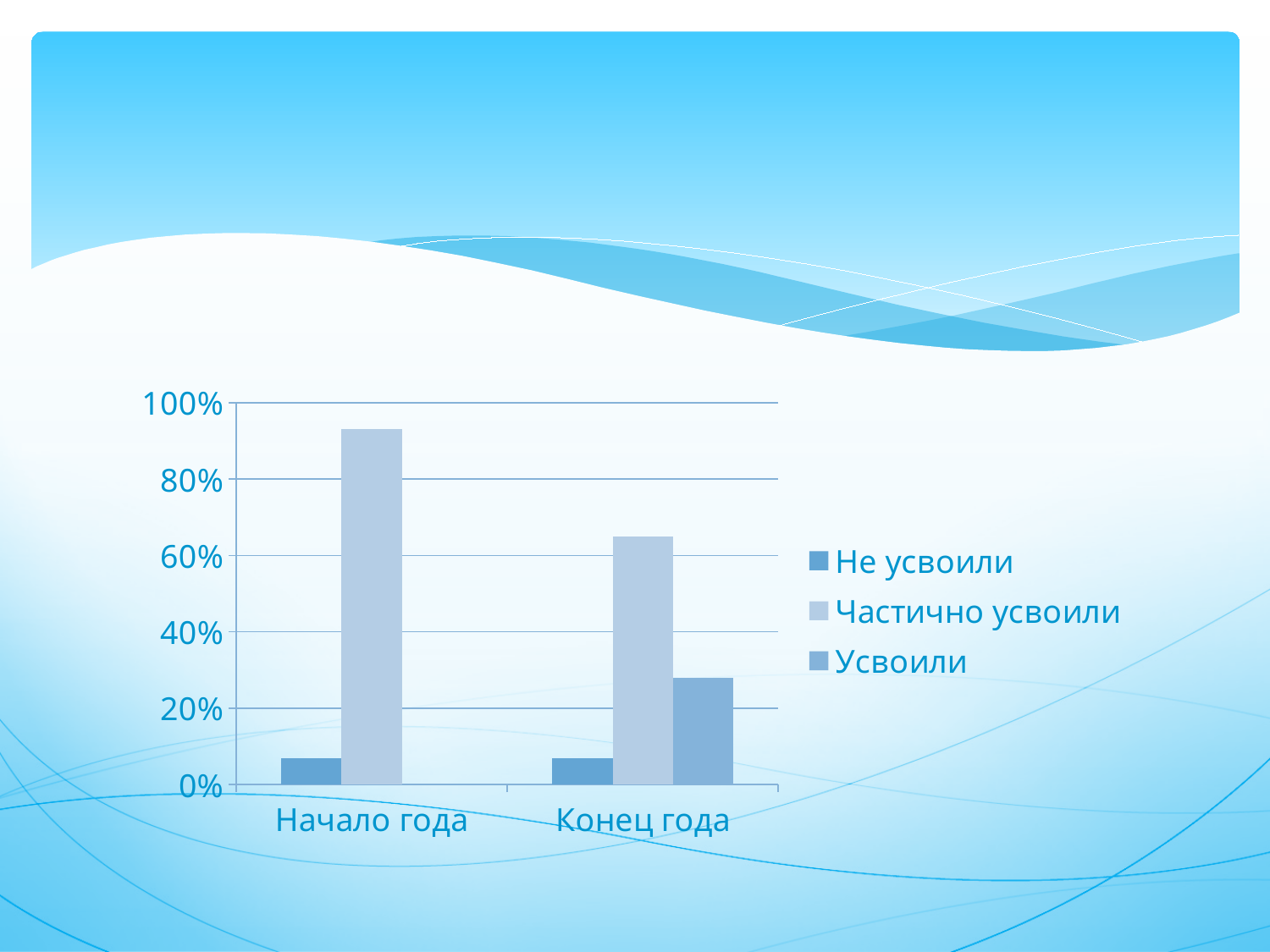
What kind of chart is shown on the slide? bar chart Is the value for Частично усвоили at Начало года greater or less than 80%? greater Which legend entry is listed first in the chart's legend? Не усвоили Which series has the highest value at Начало года? Частично усвоили Which series has the lowest value at Конец года? Не усвоили Does the value for Частично усвоили rise or fall from Начало года to Конец года? fall Is the value for Усвоили at Конец года greater or less than 40%? less Which is larger: Частично усвоили at Начало года or Частично усвоили at Конец года? Начало года How many series does the chart's legend list? 3 Is the value for Не усвоили at Начало года greater or less than 20%? less How many categories are shown on the x axis of the chart? 2